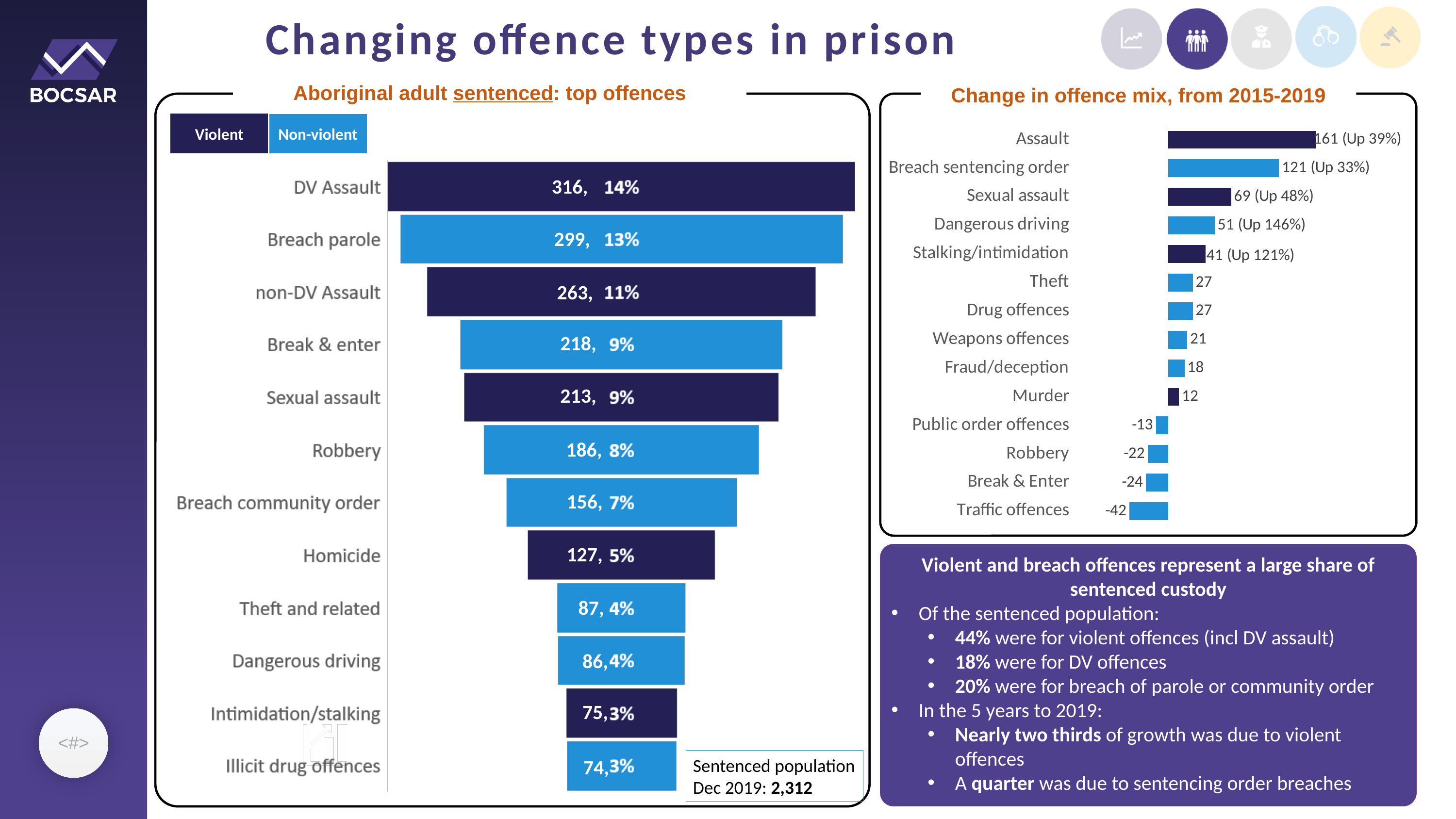
In the 'Change in offence mix, from 2015-2019' chart, what is the value shown for Traffic offences? -42 In the 'Aboriginal adult sentenced: top offences' chart, what percentage is shown for Breach parole? 13% What kind of chart is the 'Change in offence mix, from 2015-2019' chart? Bar chart In the 'Aboriginal adult sentenced: top offences' chart, how many series does the legend list? 2 In the 'Change in offence mix, from 2015-2019' chart, what is the value shown for Assault? 161 (Up 39%) In the 'Change in offence mix, from 2015-2019' chart, which is larger, the change for Sexual assault or for Dangerous driving? Sexual assault In the 'Aboriginal adult sentenced: top offences' chart, what is the difference between the counts for DV Assault and non-DV Assault? 53 In the 'Aboriginal adult sentenced: top offences' chart, which offence has the highest count? DV Assault In the 'Aboriginal adult sentenced: top offences' chart, which offence has the lowest count? Illicit drug offences In the 'Aboriginal adult sentenced: top offences' chart, how many sentenced offenders are shown for DV Assault? 316 In the 'Change in offence mix, from 2015-2019' chart, which offence has the largest decrease? Traffic offences In the 'Aboriginal adult sentenced: top offences' chart, how many offence categories are shown? 12